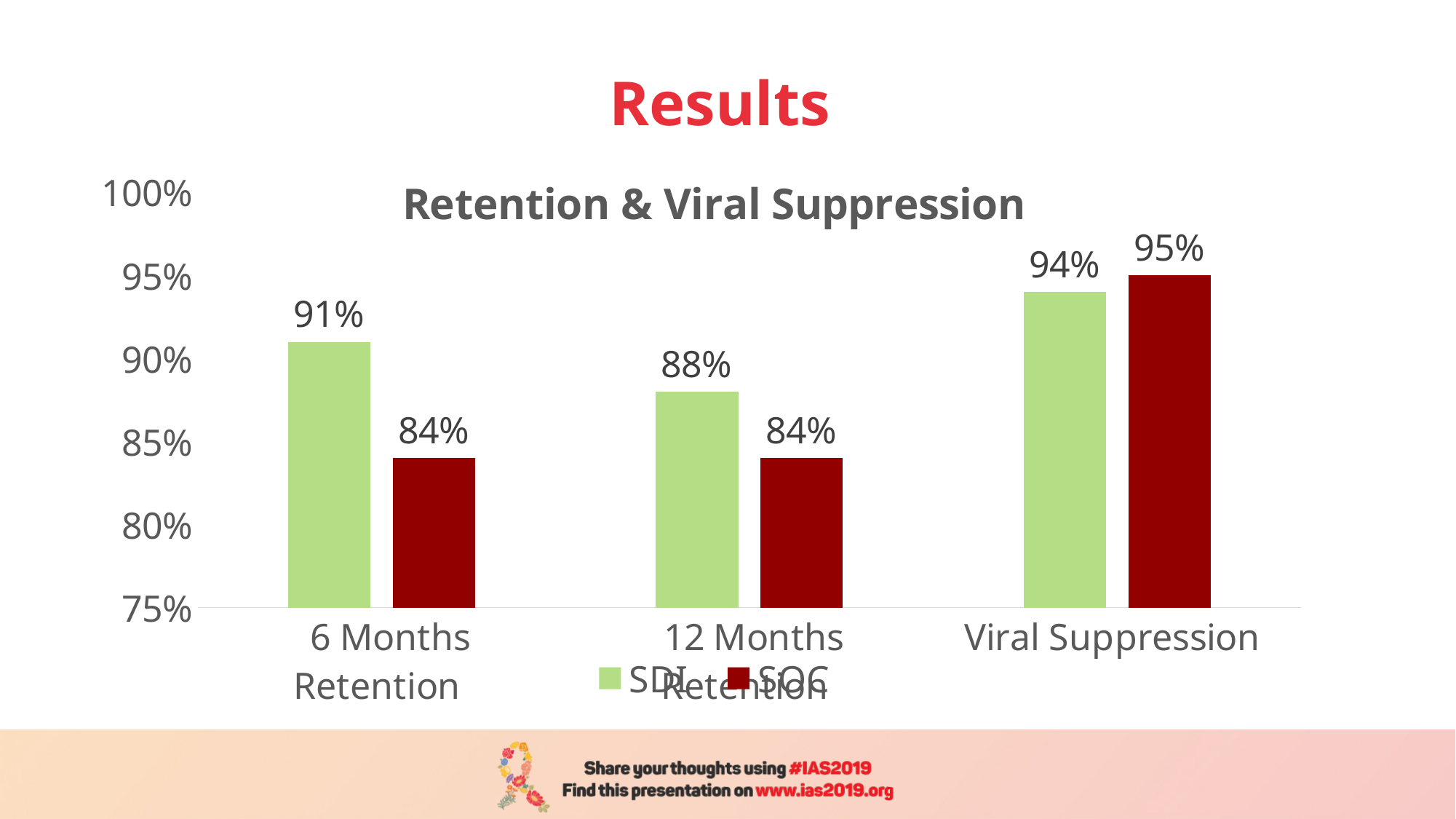
What is the SDI value for Viral Suppression? 94% How many categories are shown on the x axis? 3 What is the SOC value for 12 Months Retention? 84% How many series does the legend list? 2 What is the SDI value for 6 Months Retention? 91% What is the title of the chart? Retention & Viral Suppression What is the SOC value for Viral Suppression? 95% What is the difference between the SDI and SOC values for 6 Months Retention? 7% What kind of chart is shown on the slide? Bar chart Which category has the lowest SDI value? 12 Months Retention For 12 Months Retention, which is larger, SDI or SOC? SDI Which category has the highest SDI value? Viral Suppression